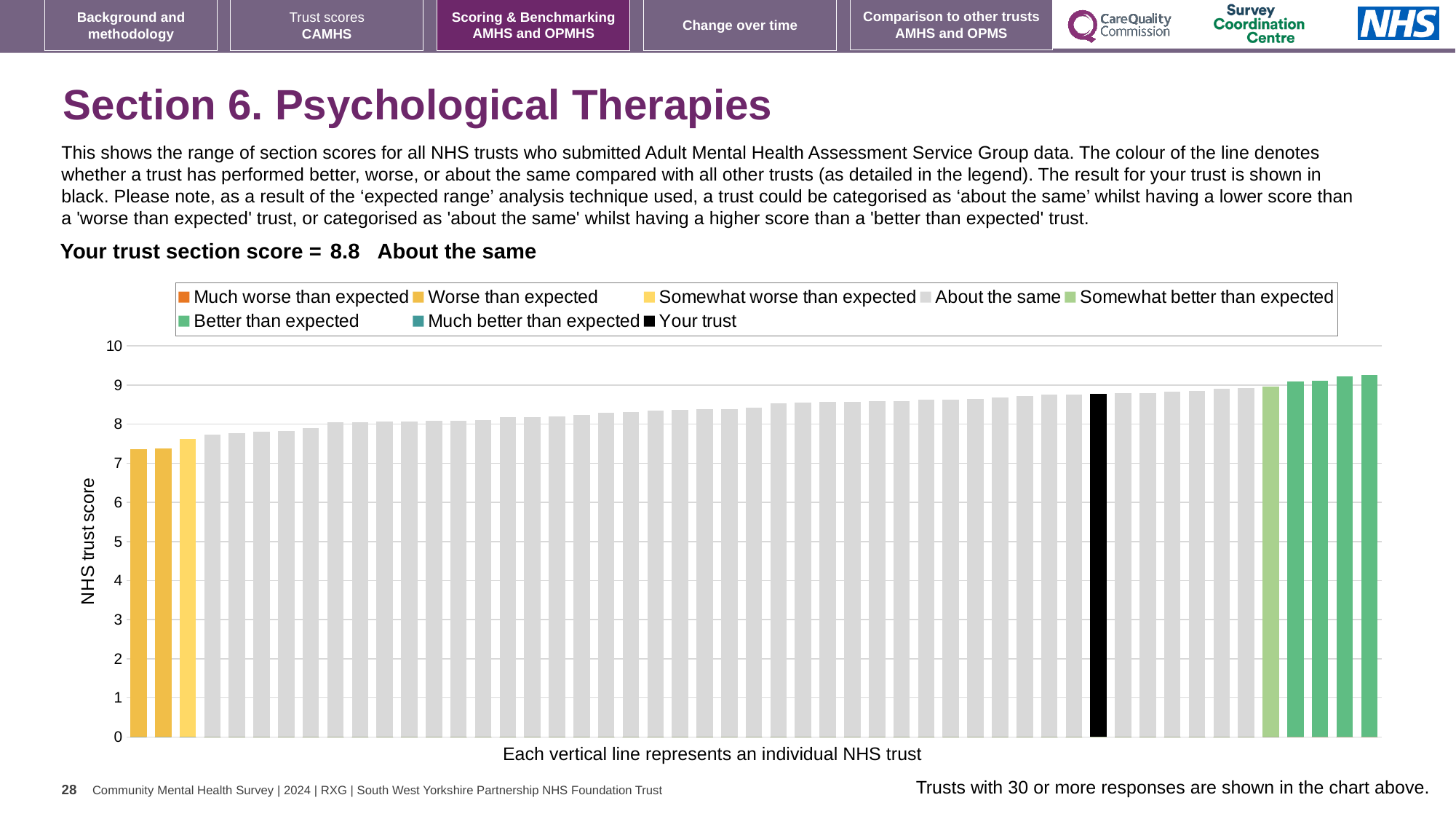
Which legend category does the highest bar in the chart belong to? Better than expected What kind of chart is shown on the slide? bar chart Is the value for 'Your trust' greater or less than 8? greater What is the label on the vertical axis of the chart? NHS trust score How many entries does the chart legend list? 8 Do the bar values rise or fall from left to right along the x axis? rise Which is larger: the value for 'Your trust' or the value of the leftmost bar? Your trust How many bars are coloured as 'Worse than expected' (orange-yellow)? 2 Is the value of the highest bar in the chart greater or less than 9? greater Is the value of the lowest bar in the chart greater or less than 8? less What is the section score for 'Your trust' shown on the slide? 8.8 How many bars are coloured as 'Better than expected' (dark green)? 4